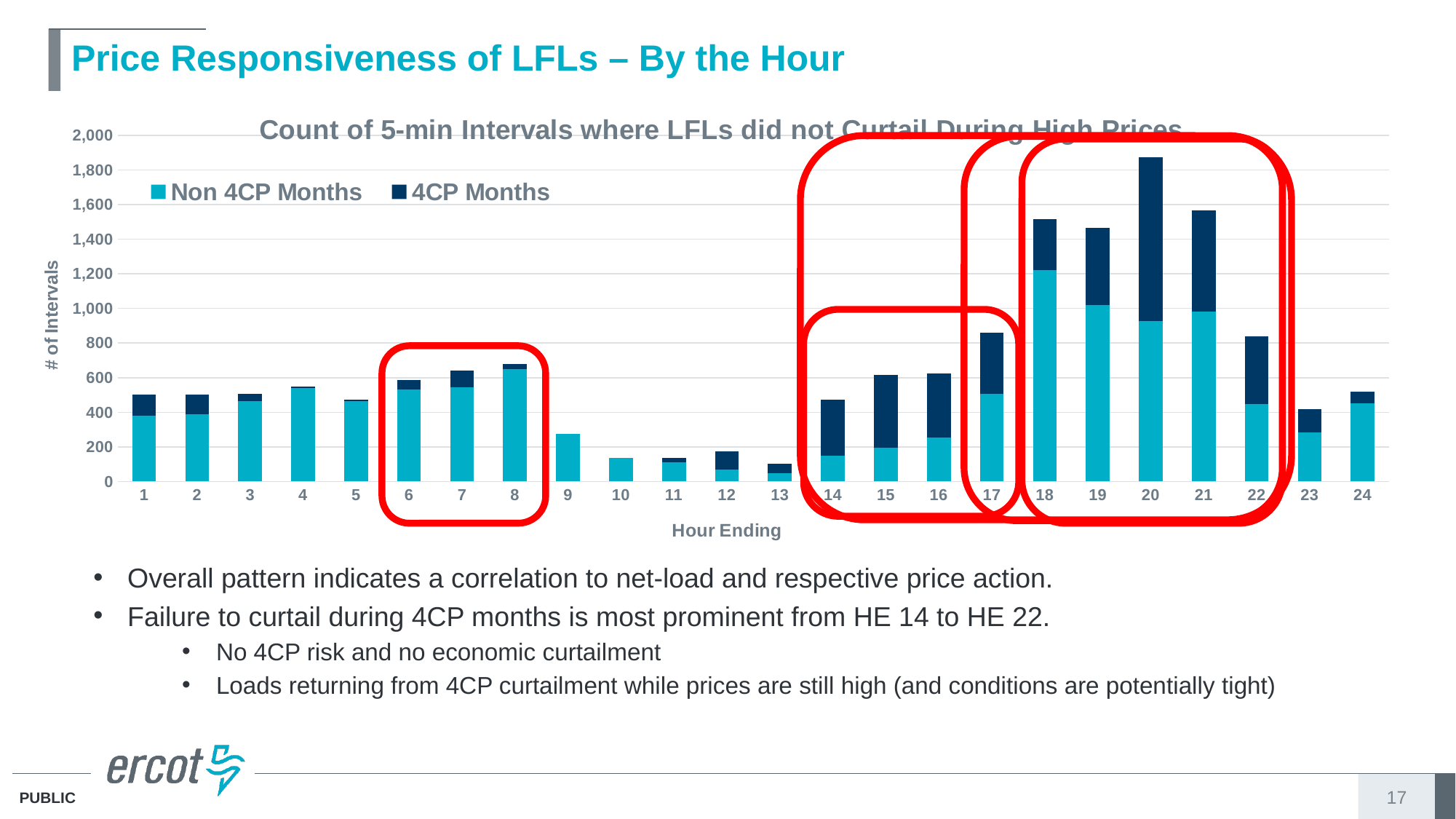
Which has the taller stacked bar, hour ending 18 or hour ending 1? 18 Is the total bar height for hour ending 20 greater or less than 1,800? greater Which hour ending has the tallest stacked bar? 20 Is the total bar height for hour ending 10 greater or less than 200? less Is the total bar height for hour ending 13 greater or less than 200? less How many series does the legend list? 2 How many hours (categories) are plotted along the x axis? 24 What are the two series named in the legend? Non 4CP Months and 4CP Months Do the total bar heights rise or fall from hour ending 20 to hour ending 23? fall What is the title of the x axis? Hour Ending What kind of chart is shown on the slide? Stacked bar chart